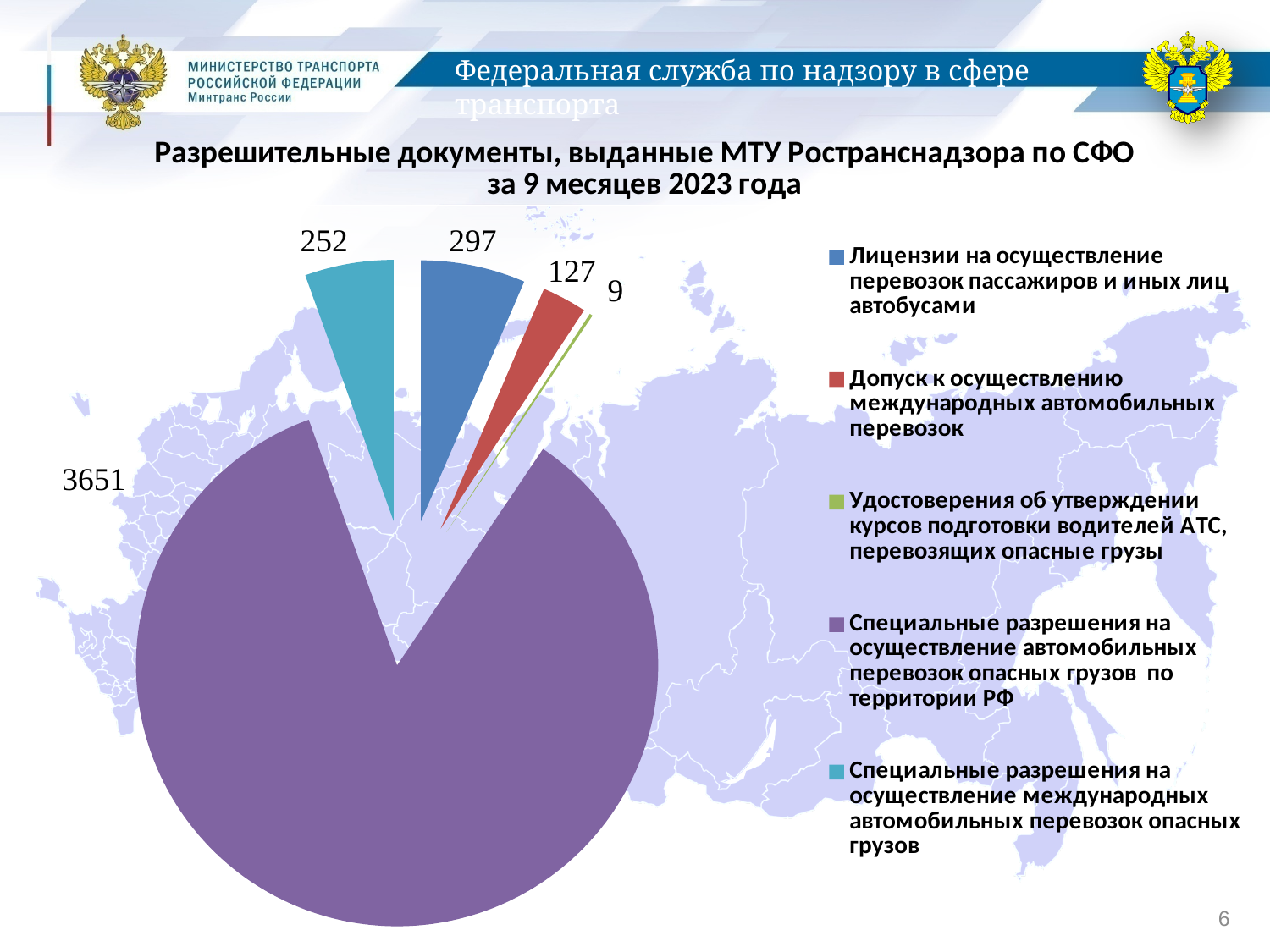
Which category has the smallest slice of the pie chart? Удостоверения об утверждении курсов подготовки водителей АТС, перевозящих опасные грузы Which is larger: the value for «Допуск к осуществлению международных автомобильных перевозок» or the value for «Специальные разрешения на осуществление международных автомобильных перевозок опасных грузов»? Специальные разрешения на осуществление международных автомобильных перевозок опасных грузов What is the value for «Допуск к осуществлению международных автомобильных перевозок»? 127 What is the value for «Лицензии на осуществление перевозок пассажиров и иных лиц автобусами»? 297 What is the value for «Удостоверения об утверждении курсов подготовки водителей АТС, перевозящих опасные грузы»? 9 What is the value for «Специальные разрешения на осуществление международных автомобильных перевозок опасных грузов»? 252 What is the difference between the value for «Лицензии на осуществление перевозок пассажиров и иных лиц автобусами» (297) and «Специальные разрешения на осуществление международных автомобильных перевозок опасных грузов» (252)? 45 What is the value for «Специальные разрешения на осуществление автомобильных перевозок опасных грузов по территории РФ»? 3651 Which category has the largest slice of the pie chart? Специальные разрешения на осуществление автомобильных перевозок опасных грузов по территории РФ What type of chart is shown on the slide? pie chart How many slices does the pie chart have? 5 How many entries does the legend of the pie chart list? 5